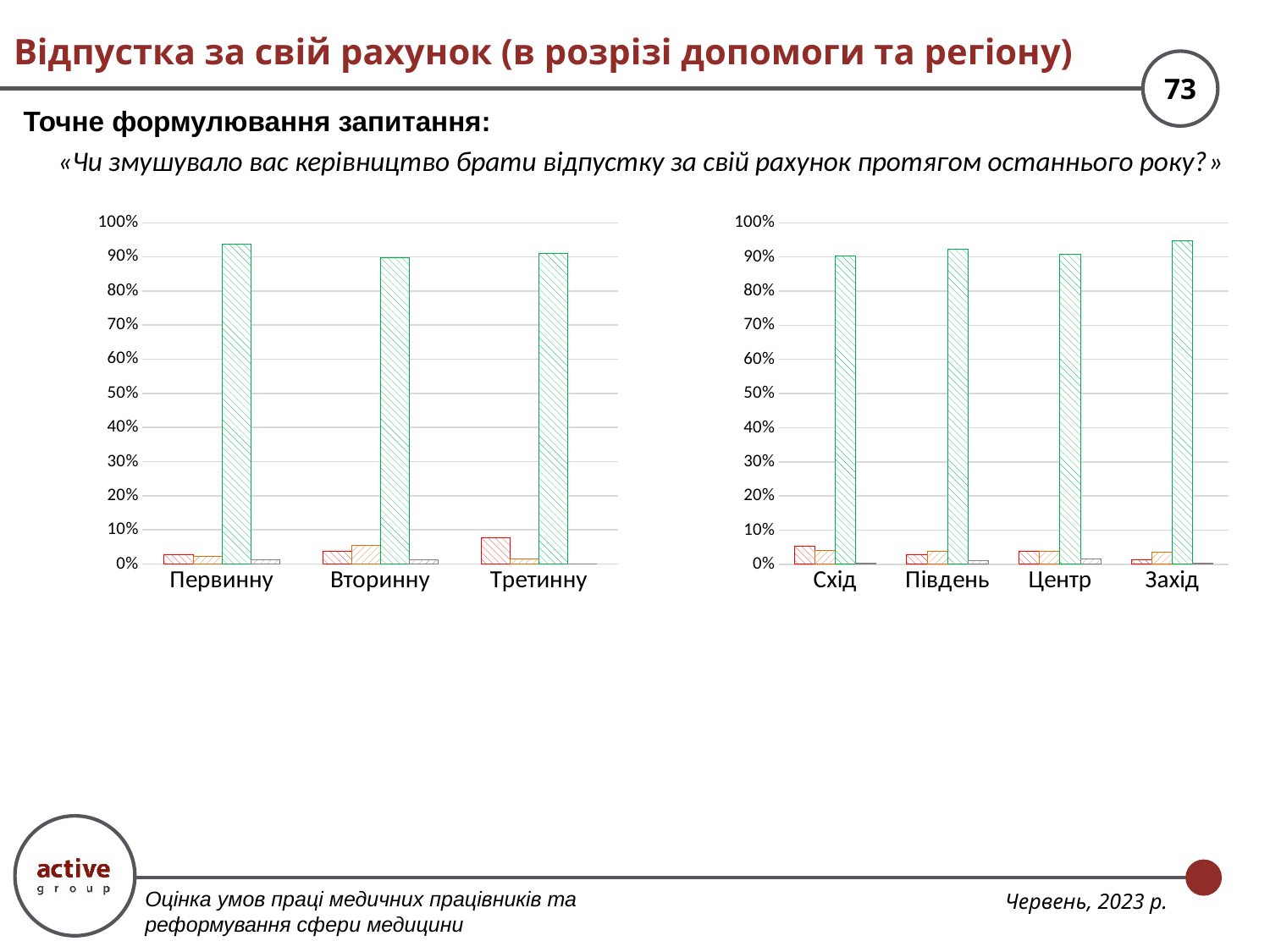
In the right chart, which category has the tallest red hatched bar? Схід In the right chart, is the red hatched bar for Схід greater or less than 10%? less What is the highest value shown on the y axis of the right chart? 100% In the right chart, which category has the tallest green hatched bar? Захід In the right chart, is the tallest (green hatched) bar for Захід greater or less than 90%? greater In the left chart, is the red hatched bar for Третинну greater or less than 10%? less In the left chart, which category has the tallest red hatched bar? Третинну How many categories are shown on the x axis of the left chart? 3 How many categories are shown on the x axis of the right chart? 4 What kind of chart is the left chart on the slide? bar chart